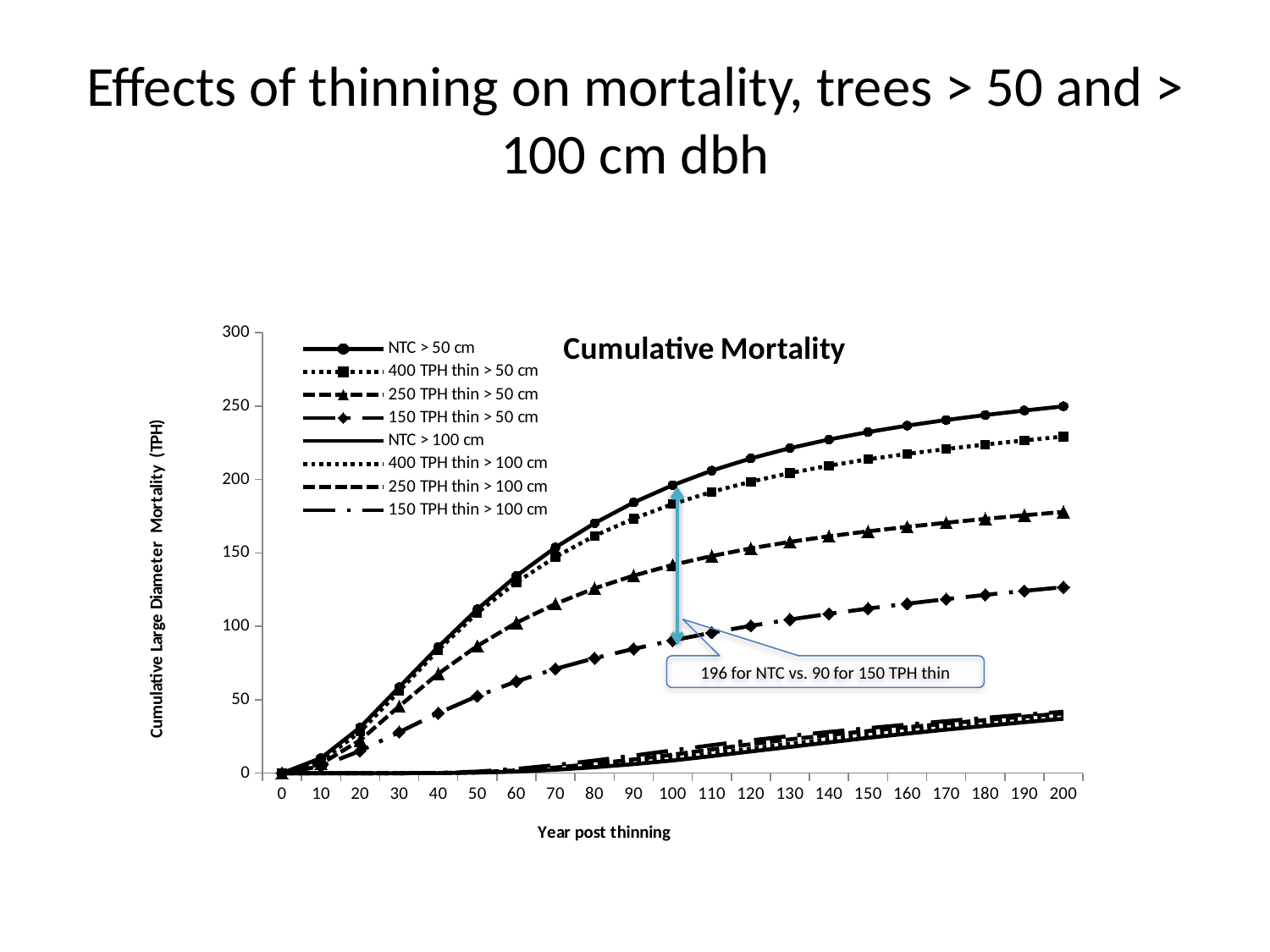
How many series does the legend list? 8 What is the label of the x axis? Year post thinning According to the callout, what is the cumulative mortality for 150 TPH thin > 50 cm at year 100? 90 Is the value for NTC > 50 cm at year 200 greater or less than 200? greater Is the value for 150 TPH thin > 50 cm at year 200 greater or less than 150? less Which series has the highest value at year 200? NTC > 50 cm Does the NTC > 50 cm series rise or fall as year post thinning increases? rise According to the callout, what is the cumulative mortality for NTC > 50 cm at year 100? 196 What is the title of the chart? Cumulative Mortality Is the value for 250 TPH thin > 50 cm at year 200 greater or less than 150? greater At year 100, what is the difference between the NTC > 50 cm value and the 150 TPH thin > 50 cm value given in the callout? 106 What kind of chart is shown on the slide? line chart